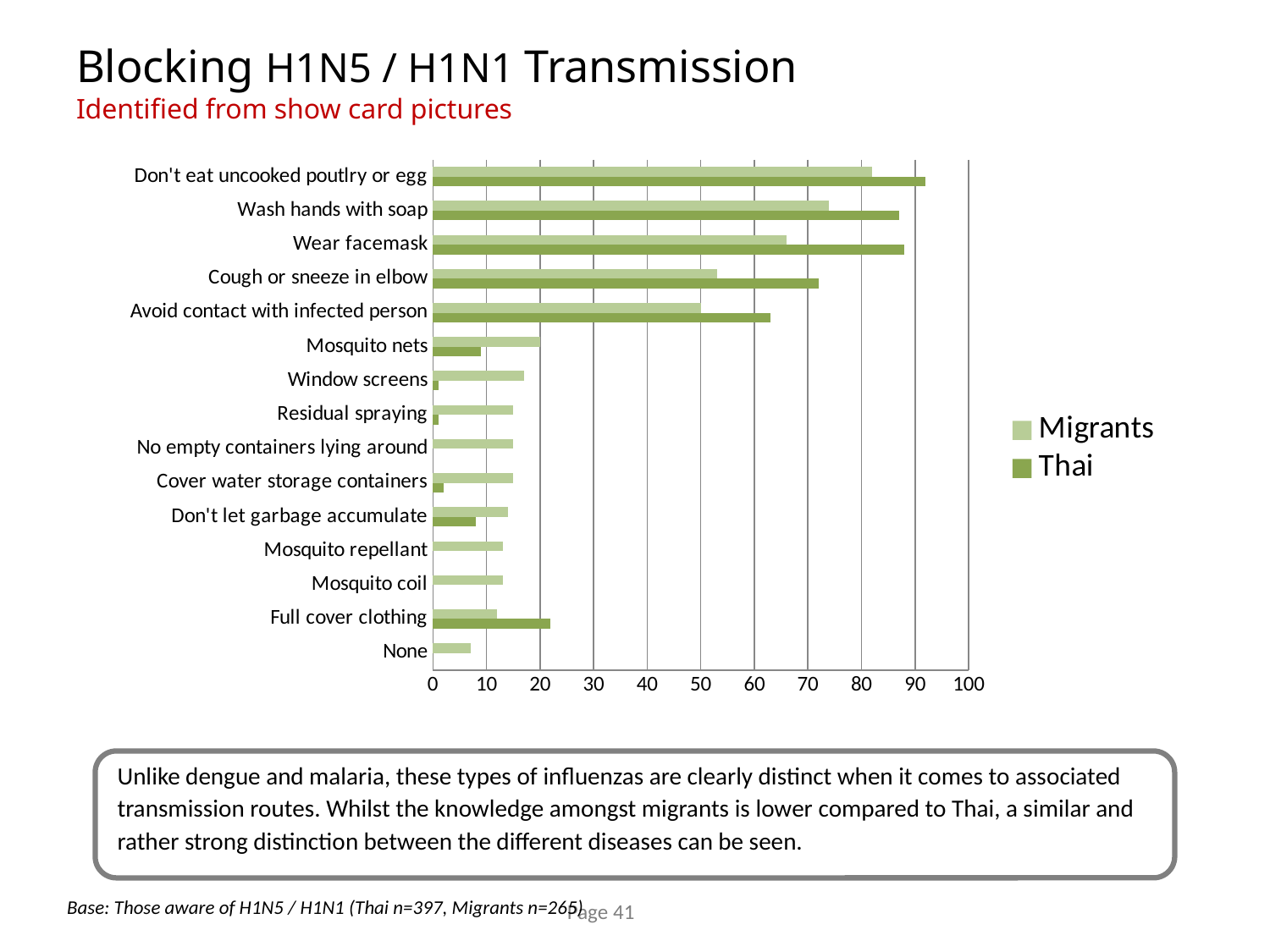
How many categories are plotted on the chart? 15 For Mosquito nets, which series has the larger value, Migrants or Thai? Migrants Which category has the lowest value for Migrants? None What are the two series named in the legend? Migrants and Thai Is the Migrants value for Wear facemask greater or less than 60? greater Is the Migrants value for Mosquito nets greater or less than 30? less How many series does the legend list? 2 What kind of chart is shown on the slide? bar chart Is the Thai value for Wash hands with soap greater or less than 80? greater For Wear facemask, which series has the larger value, Migrants or Thai? Thai Which category has the highest value for Migrants? Don't eat uncooked poutlry or egg